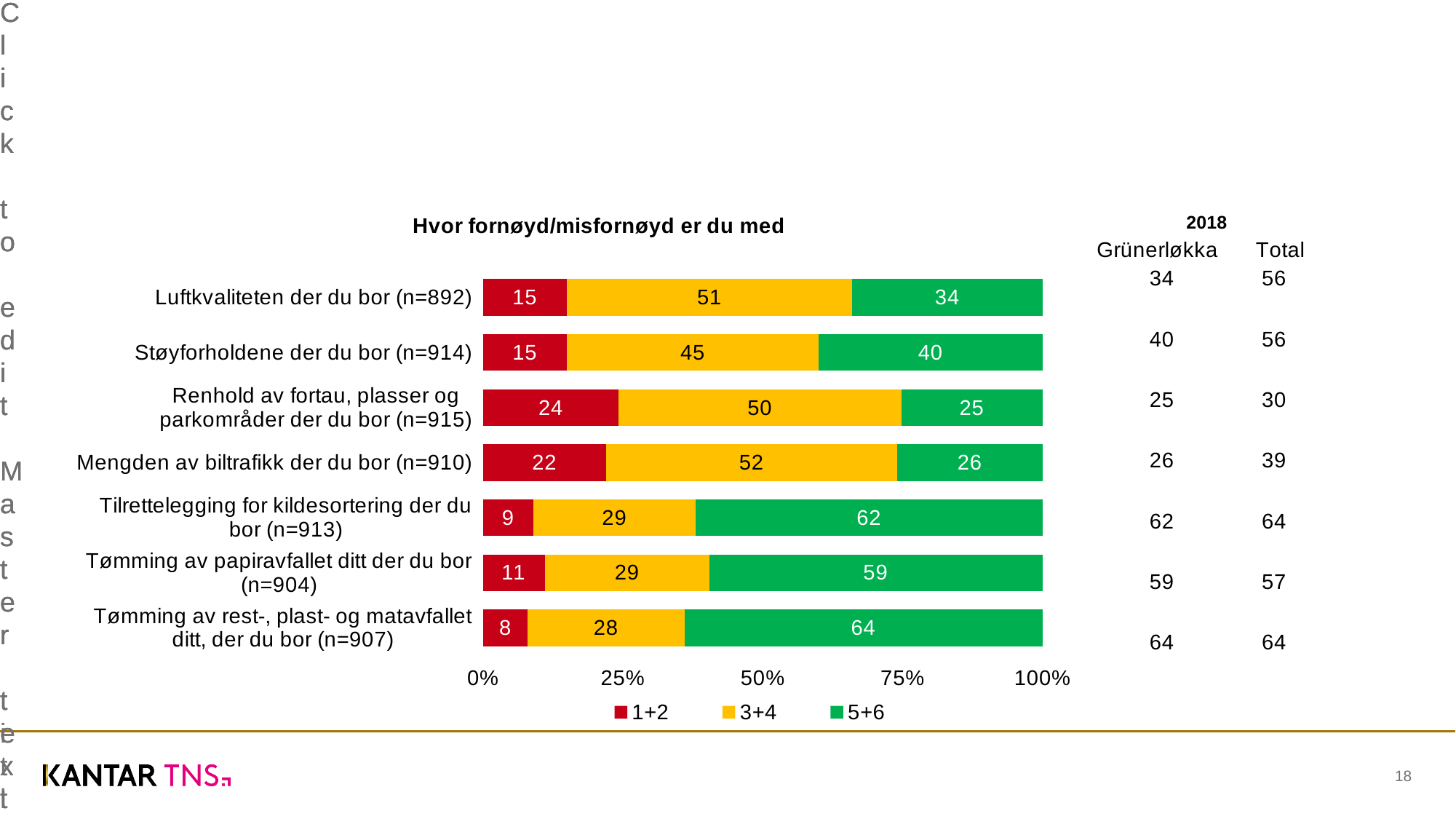
Which category has the highest value in the 5+6 series? Tømming av rest-, plast- og matavfallet ditt, der du bor (n=907) What is the difference between the 5+6 values for "Tilrettelegging for kildesortering der du bor (n=913)" and "Tømming av papiravfallet ditt der du bor (n=904)"? 3 What kind of chart is shown on the slide? Stacked bar chart What is the title of the chart? Hvor fornøyd/misfornøyd er du med What is the total of the stacked bar for "Renhold av fortau, plasser og parkområder der du bor (n=915)"? 99 How many categories are shown in the chart? 7 What is the value of the 1+2 series for "Renhold av fortau, plasser og parkområder der du bor (n=915)"? 24 What is the value of the 5+6 series for "Luftkvaliteten der du bor (n=892)"? 34 How many series does the legend list? 3 Which category has the lowest value in the 1+2 series? Tømming av rest-, plast- og matavfallet ditt, der du bor (n=907) What is the value of the 3+4 series for "Støyforholdene der du bor (n=914)"? 45 Which is larger: the 3+4 value for "Mengden av biltrafikk der du bor (n=910)" or the 3+4 value for "Luftkvaliteten der du bor (n=892)"? Mengden av biltrafikk der du bor (n=910)